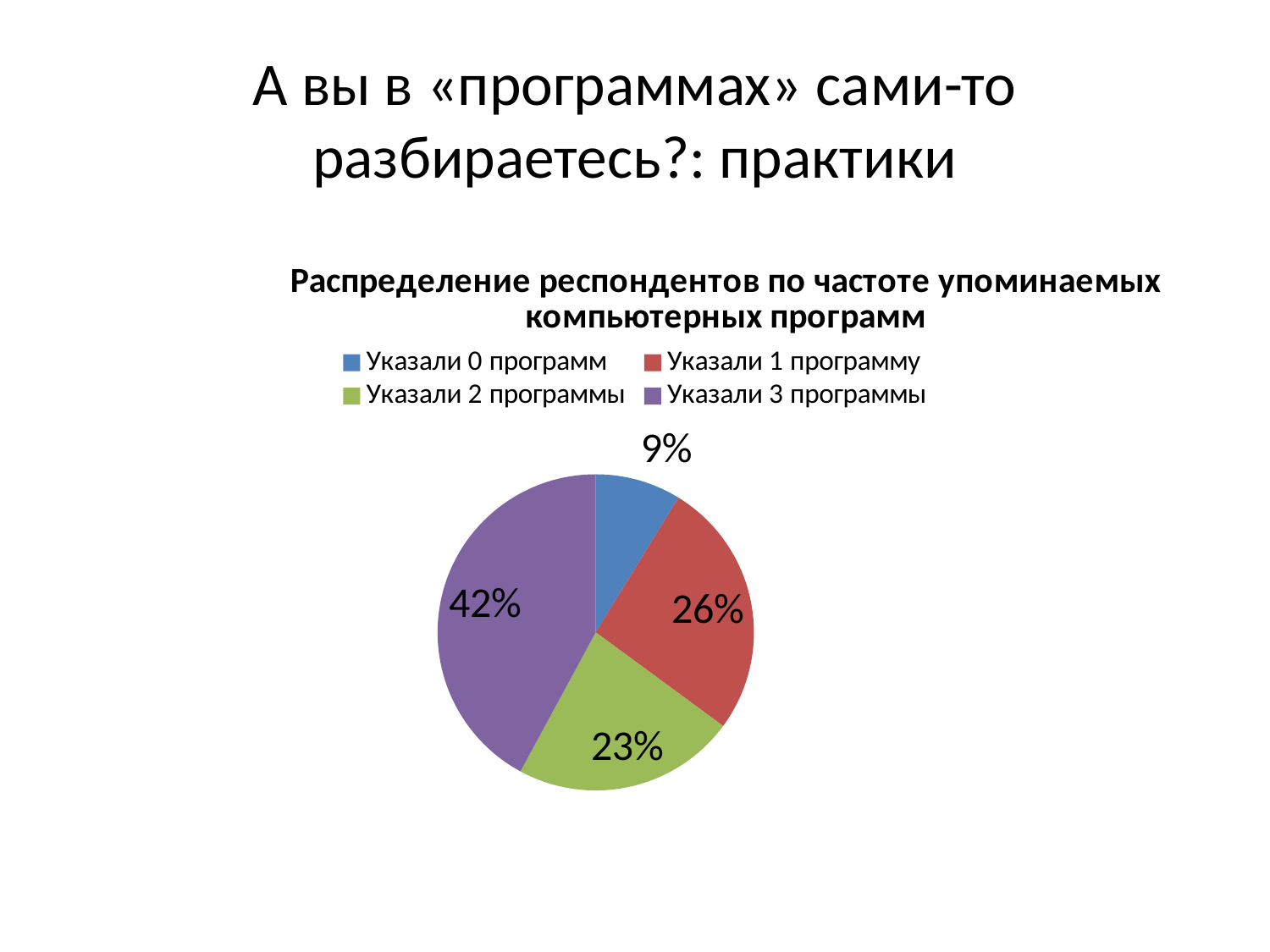
Which is larger: the share for "Указали 1 программу" or for "Указали 2 программы"? Указали 1 программу What share of respondents is shown for "Указали 3 программы"? 42% What share of respondents is shown for "Указали 1 программу"? 26% What colour is the slice for "Указали 3 программы"? purple Which category has the smallest slice of the pie? Указали 0 программ What is the difference in percentage points between "Указали 3 программы" and "Указали 1 программу"? 16 How many slices does the pie chart have? 4 What is the title of the chart? Распределение респондентов по частоте упоминаемых компьютерных программ What kind of chart is shown on the slide? pie chart What share of respondents is shown for "Указали 0 программ"? 9% What share of respondents is shown for "Указали 2 программы"? 23% Which category has the largest slice of the pie? Указали 3 программы